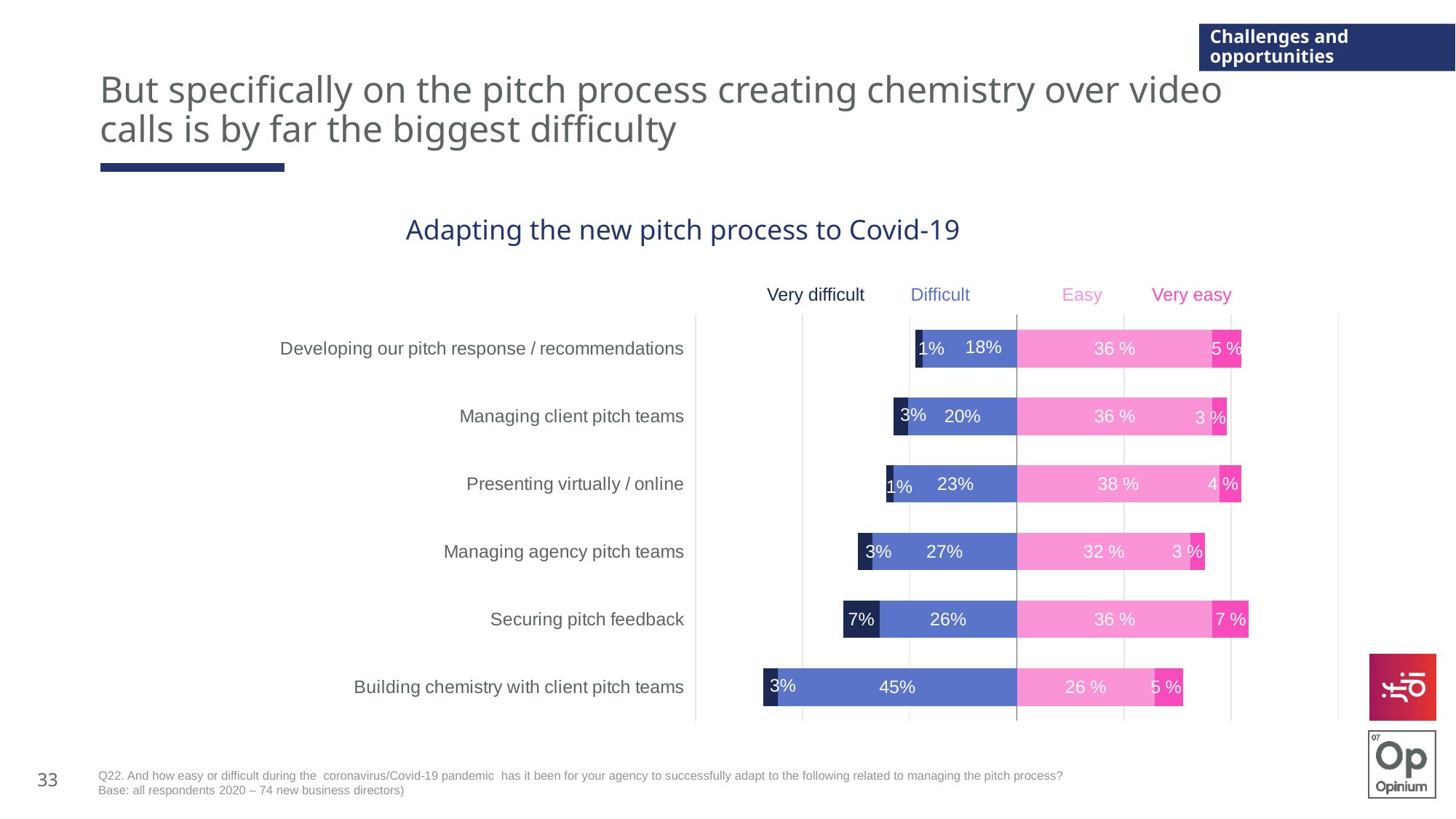
What is the value for Very difficult for Securing pitch feedback? 7% How many categories are shown in the chart? 6 What is the value for Very easy for Managing client pitch teams? 3 % What is the value for Easy for Presenting virtually / online? 38 % Which category has the highest value for Difficult? Building chemistry with client pitch teams What is the value for Difficult for Building chemistry with client pitch teams? 45% What is the combined value of Very difficult and Difficult for Securing pitch feedback? 33% How many series does the legend list? 4 Which category has the highest value for Very easy? Securing pitch feedback What is the difference between the Difficult values for Building chemistry with client pitch teams and Managing agency pitch teams? 18% Which has the larger Easy value: Managing agency pitch teams or Managing client pitch teams? Managing client pitch teams Which category has the lowest value for Easy? Building chemistry with client pitch teams